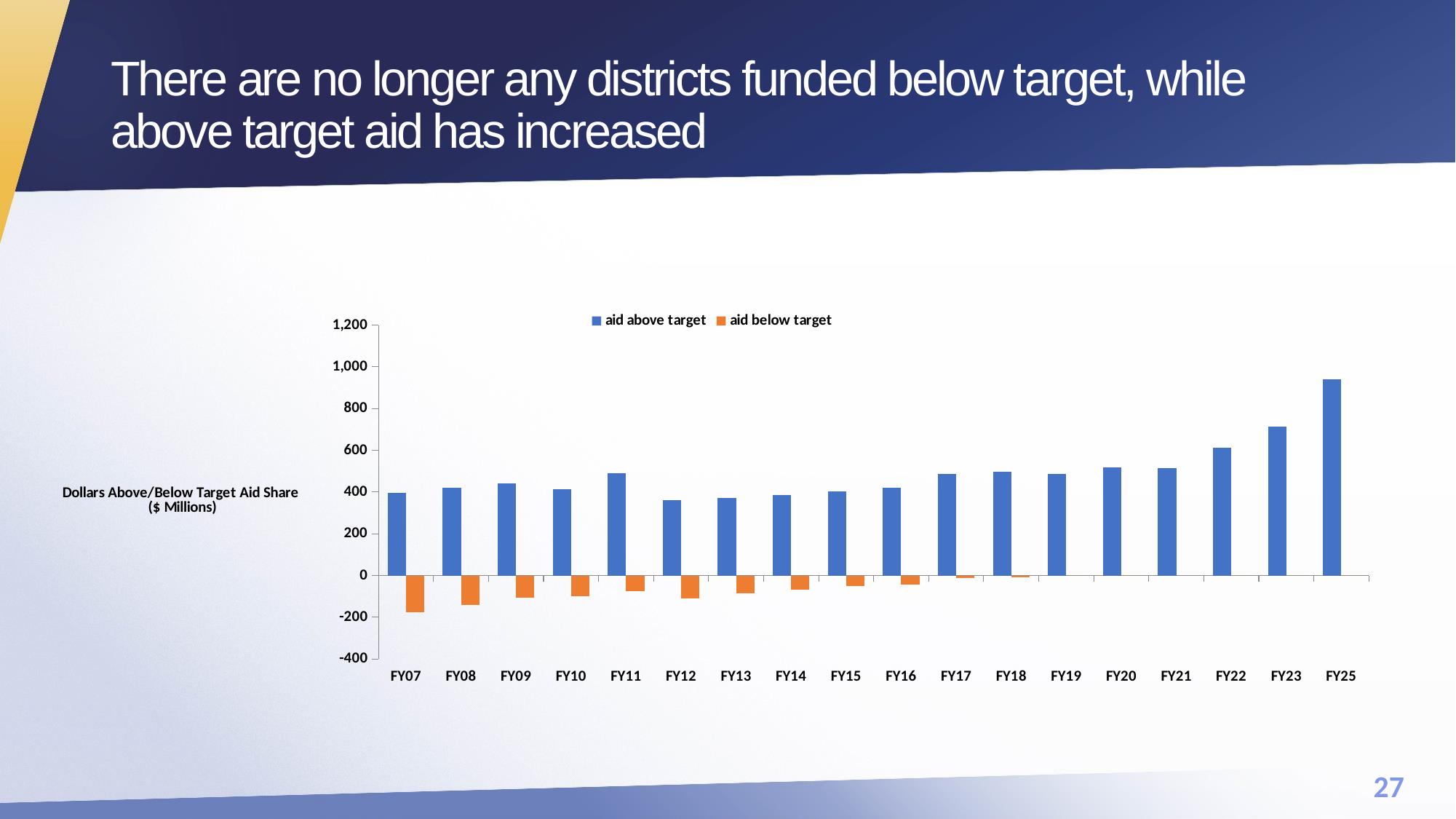
Is the value for aid below target in FY07 greater or less than -100? less What kind of chart is shown on the slide? bar chart Does aid above target generally rise or fall from FY07 to FY25? rise How many fiscal years are shown on the x axis? 18 What colour represents aid below target in the chart? orange Is the value for aid above target in FY23 greater or less than 600? greater Which fiscal year has the highest value for aid above target? FY25 How many series does the legend list? 2 Which is larger, aid above target in FY25 or in FY23? FY25 Is the value for aid above target in FY25 greater or less than 800? greater Which fiscal year has the largest negative value for aid below target? FY07